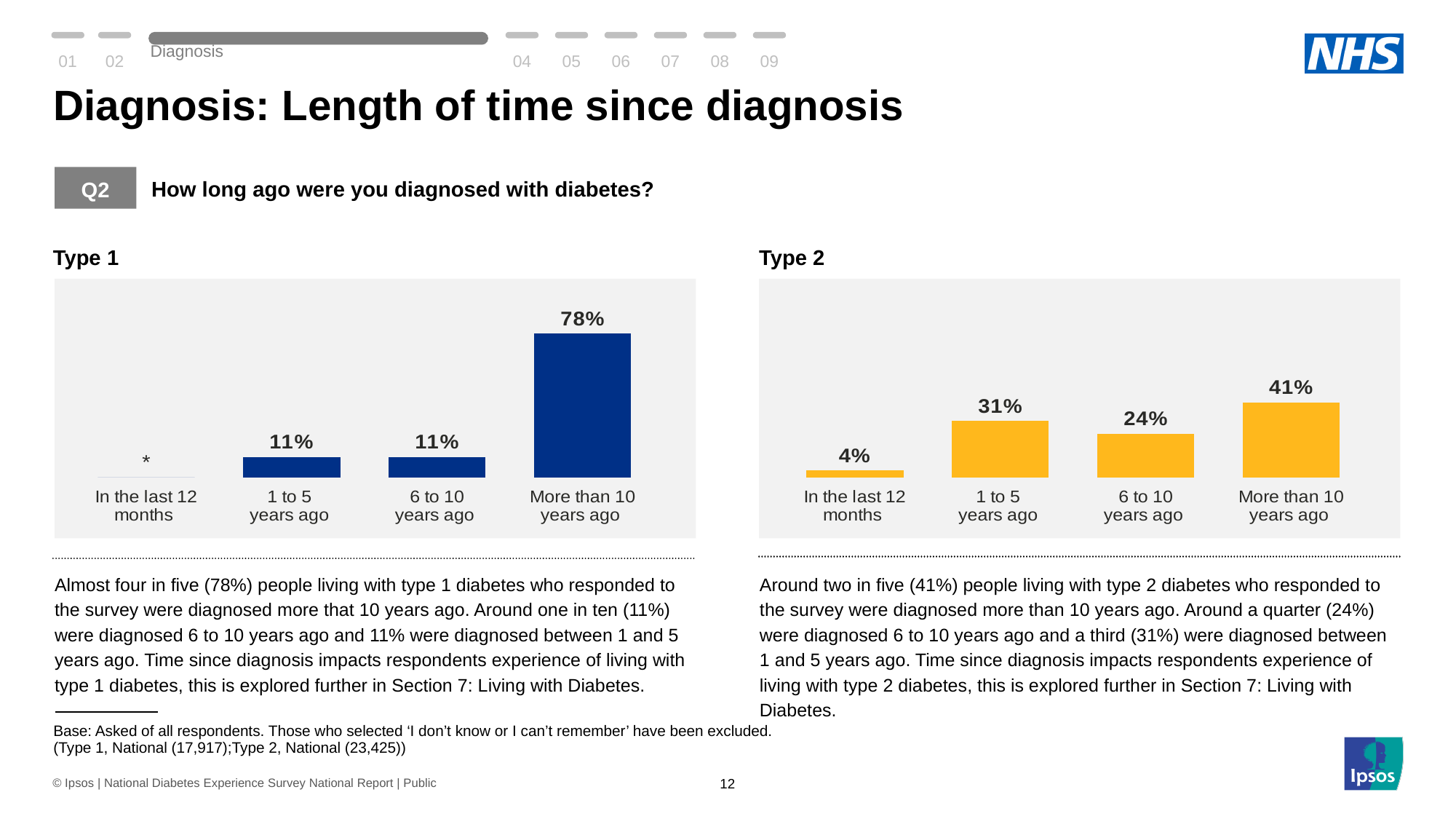
What kind of chart is the Type 2 chart? Bar chart In the Type 2 chart, which category has the highest value? More than 10 years ago In the Type 2 chart, what is the value for 1 to 5 years ago? 31% In the Type 2 chart, what is the difference between the values for More than 10 years ago and 6 to 10 years ago? 17% What is the difference between the More than 10 years ago value in the Type 1 chart and the More than 10 years ago value in the Type 2 chart? 37% In the Type 1 chart, what percentage of respondents were diagnosed more than 10 years ago? 78% In the Type 2 chart, what percentage of respondents were diagnosed in the last 12 months? 4% What colour are the bars in the Type 1 chart? Dark blue How many categories are shown on the x axis of the Type 1 chart? 4 In the Type 1 chart, what is the value for 6 to 10 years ago? 11% In the Type 2 chart, which category has the lowest value? In the last 12 months In the Type 2 chart, which is larger: the value for 1 to 5 years ago or the value for 6 to 10 years ago? 1 to 5 years ago